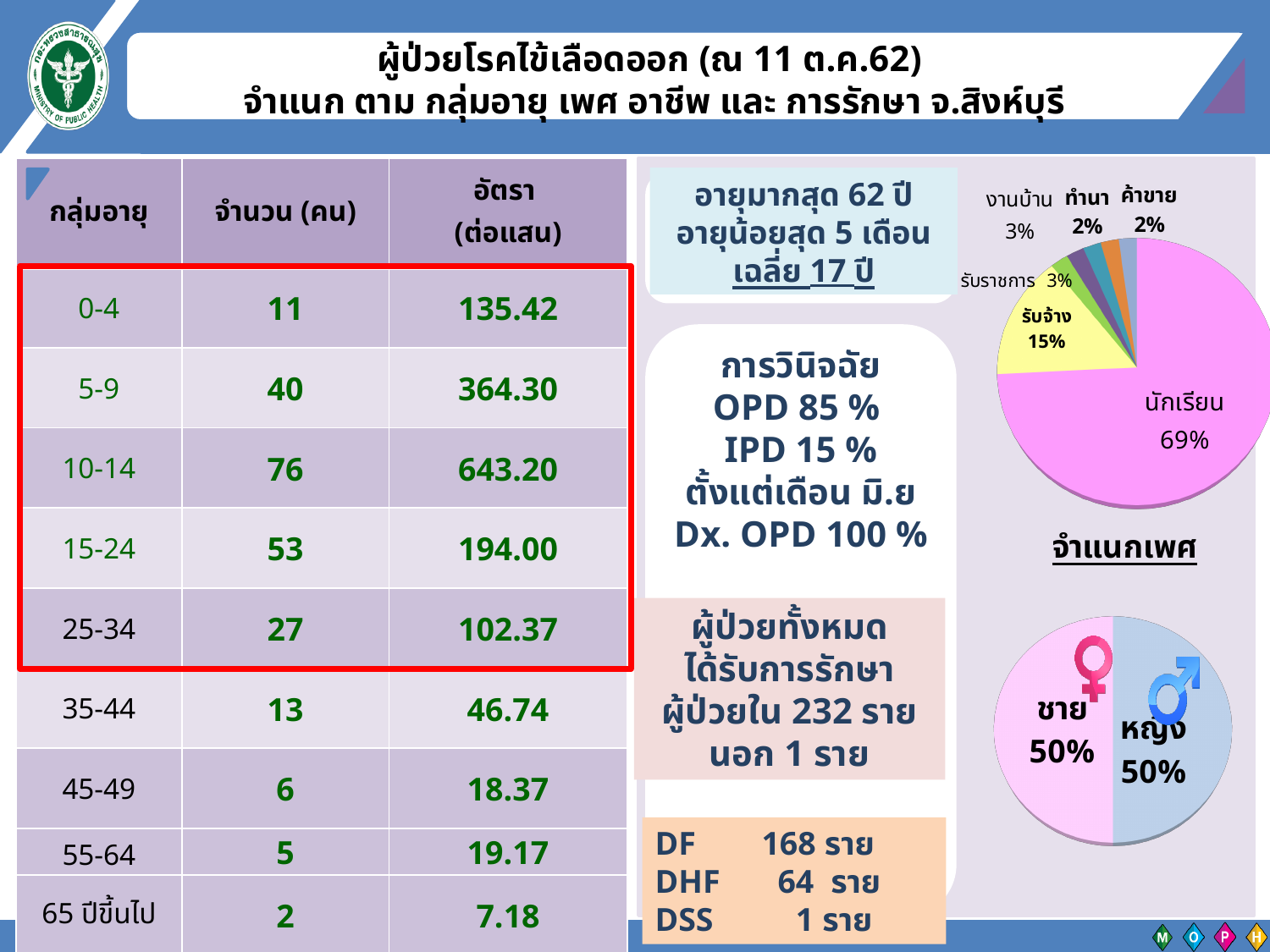
In the จำแนกเพศ pie chart at the bottom right, what share of patients are ชาย? 50% What is the title of the pie chart at the bottom right of the slide? จำแนกเพศ What kind of chart is the occupation chart at the top right of the slide? Pie chart In the occupation pie chart at the top right, what share of patients are ทำนา? 2% How many slices does the จำแนกเพศ pie chart at the bottom right have? 2 In the occupation pie chart at the top right, how many percentage points larger is the นักเรียน slice than the รับจ้าง slice? 54 percentage points In the occupation pie chart at the top right, what share of patients are นักเรียน? 69% In the occupation pie chart at the top right, which occupation has the largest slice? นักเรียน In the occupation pie chart at the top right, which slice is larger: รับจ้าง or รับราชการ? รับจ้าง